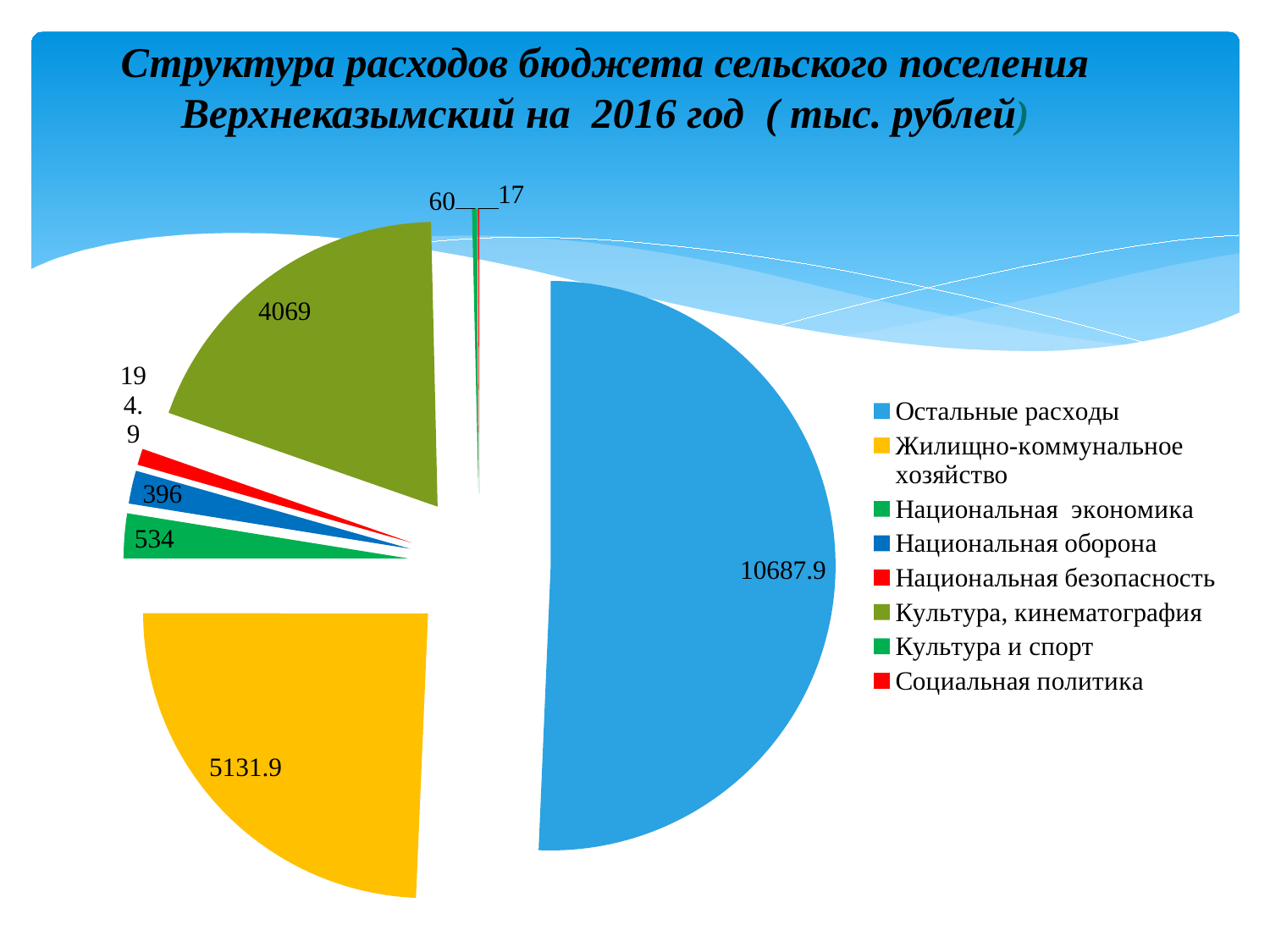
What is the value for Остальные расходы? 10687.9 Which is larger, the value for Национальная экономика or the value for Национальная оборона? Национальная экономика Which category has the largest slice of the pie? Остальные расходы What is the value for Жилищно-коммунальное хозяйство? 5131.9 What is the title of the chart? Структура расходов бюджета сельского поселения Верхнеказымский на 2016 год ( тыс. рублей) What is the value for Национальная экономика? 534 What is the value for Национальная оборона? 396 What is the value for Культура, кинематография? 4069 How many categories does the legend list? 8 Which category has the smallest slice of the pie? Социальная политика What type of chart is shown on the slide? pie chart What is the difference between the values for Остальные расходы and Жилищно-коммунальное хозяйство? 5556